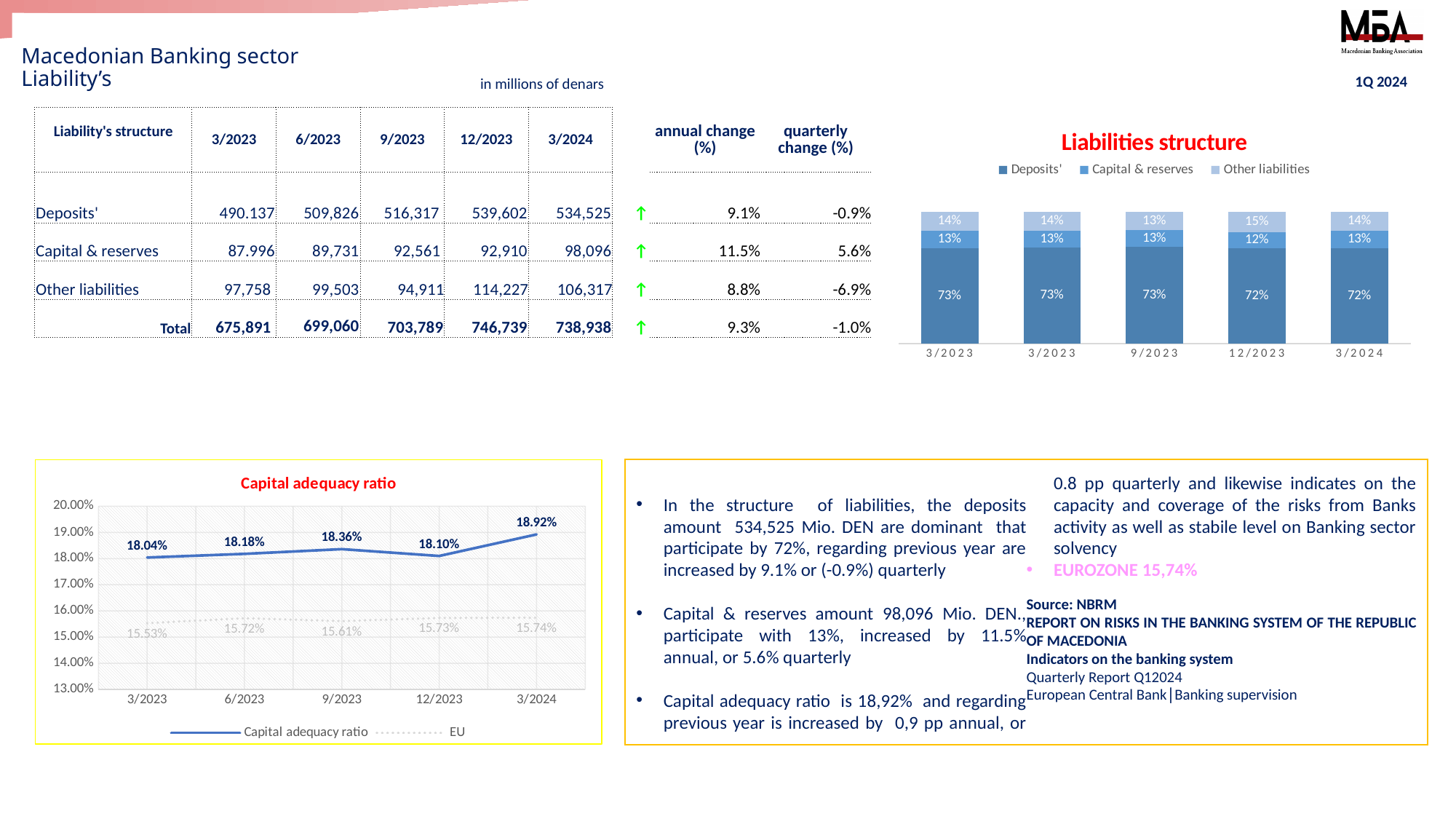
In the Liabilities structure chart, what share do Other liabilities make up in 12/2023? 15% How many periods are plotted on the x axis of the Capital adequacy ratio chart? 5 In the Capital adequacy ratio chart, which period has the lowest Capital adequacy ratio? 3/2023 What kind of chart is the Liabilities structure chart? Stacked bar chart In the Liabilities structure chart, what share do Deposits' make up in 3/2024? 72% In the Capital adequacy ratio chart, which period has the highest Capital adequacy ratio? 3/2024 In the Capital adequacy ratio chart, what is the difference between the Capital adequacy ratio and the EU value in 3/2024? 3.18% In the Capital adequacy ratio chart, what is the Capital adequacy ratio for 3/2024? 18.92% In the Capital adequacy ratio chart, what is the EU value for 3/2023? 15.53% In the Liabilities structure chart, which series has the largest share in 12/2023? Deposits' In the Liabilities structure chart, what share do Capital & reserves make up in 9/2023? 13% How many series does the legend of the Liabilities structure chart list? 3